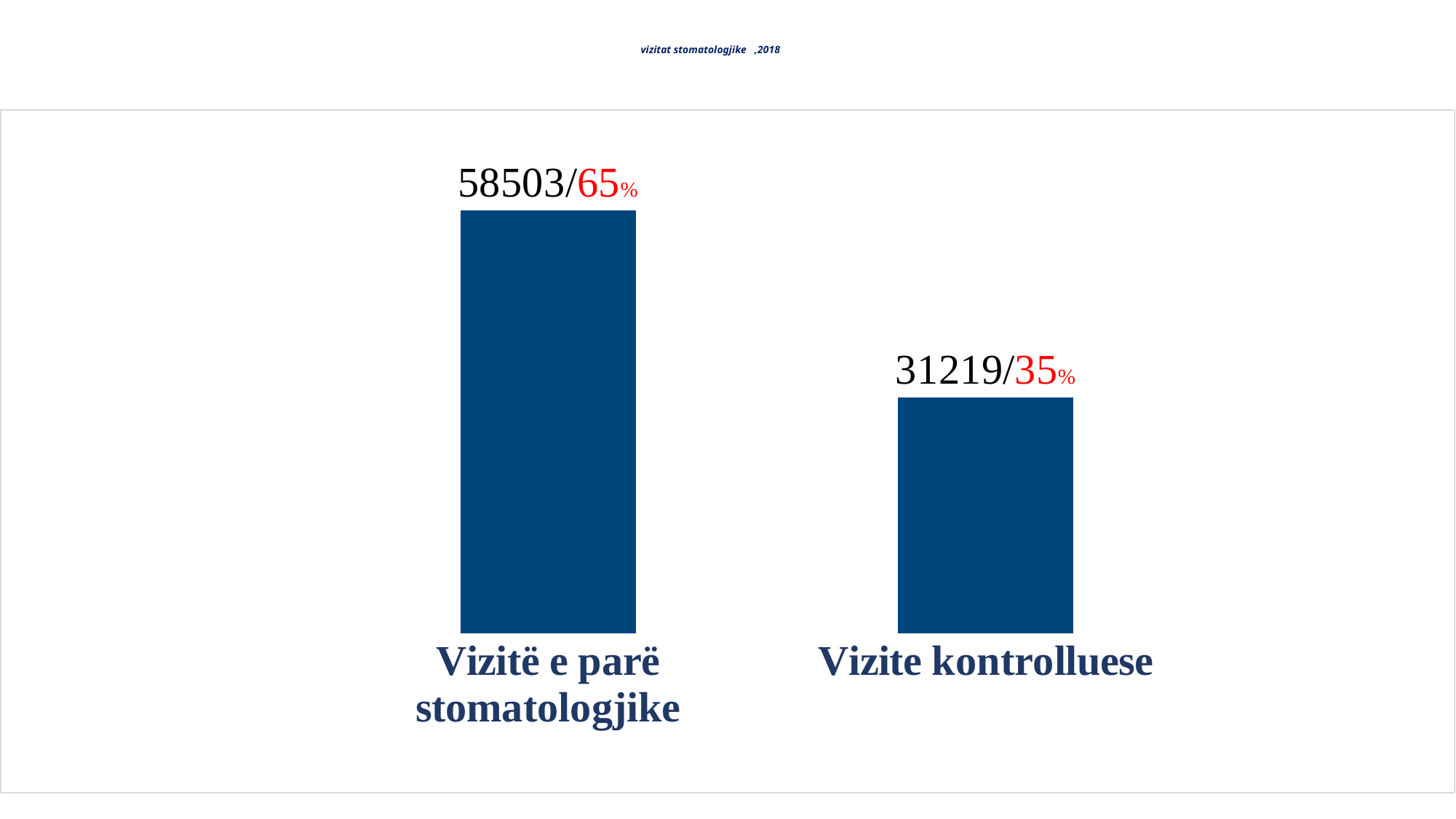
Which category has the highest value? Vizitë e parë stomatologjike What value is shown for Vizite kontrolluese? 31219/35% What kind of chart is shown on the slide? Bar chart What is the title of the chart? vizitat stomatologjike ,2018 Which is larger, Vizitë e parë stomatologjike or Vizite kontrolluese? Vizitë e parë stomatologjike How many categories are shown in the chart? 2 What value is shown for Vizitë e parë stomatologjike? 58503/65% What is the difference in count between Vizitë e parë stomatologjike and Vizite kontrolluese? 27284 What is the difference in percentage points between Vizitë e parë stomatologjike and Vizite kontrolluese? 30 What percentage is shown for Vizitë e parë stomatologjike? 65% Which category has the lowest value? Vizite kontrolluese What percentage is shown for Vizite kontrolluese? 35%